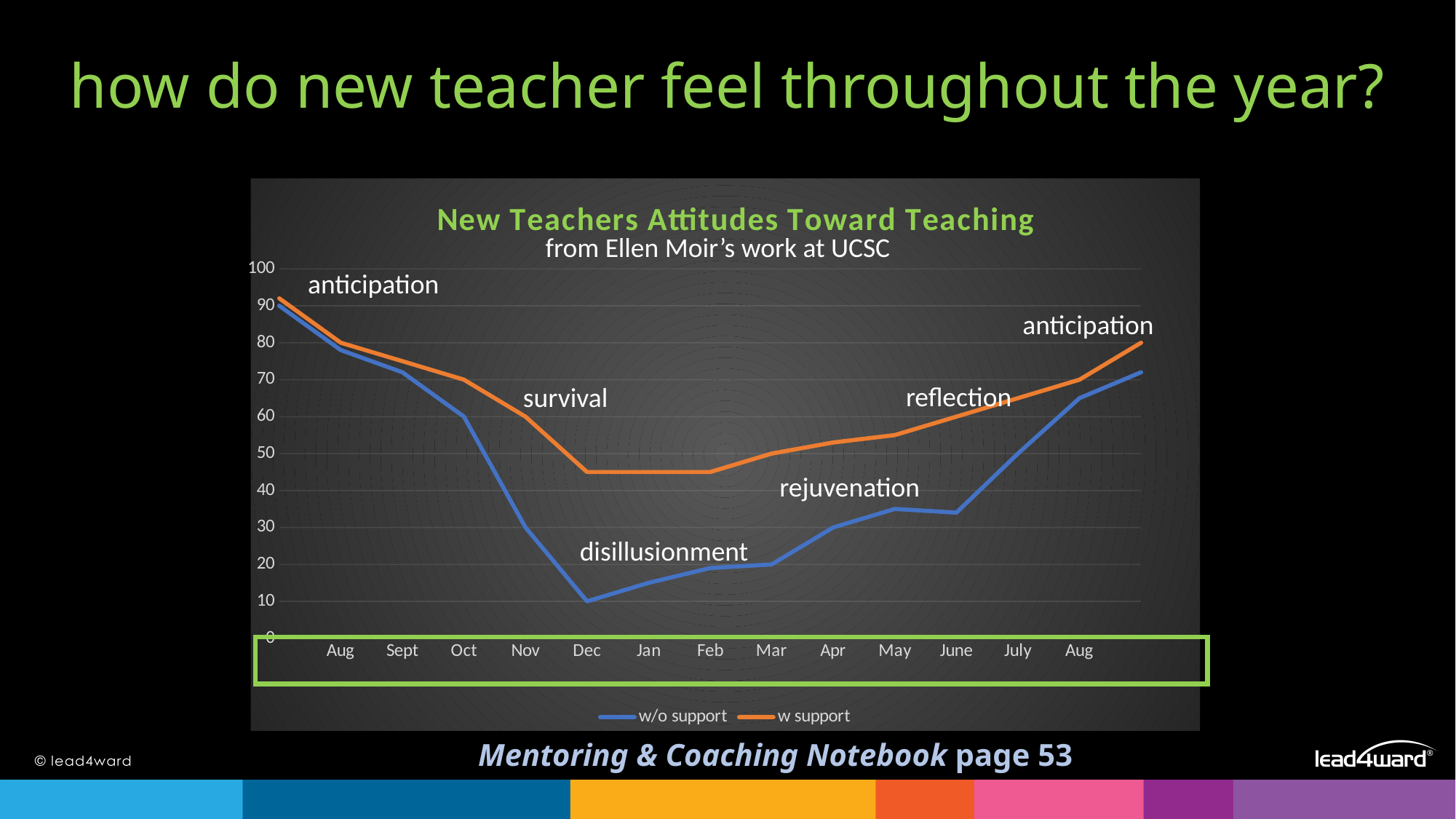
In which month does the w/o support line reach its lowest point? Dec What kind of chart is shown on the slide? line chart Is the value for w support in May greater or less than 50? greater How many series does the chart legend list? 2 How many months are labelled along the x axis? 13 In Dec, which series has the larger value, w/o support or w support? w support Is the value for w support in Dec greater or less than 40? greater Is the value for w/o support in Dec greater or less than 20? less What are the two series named in the legend? w/o support and w support What is the title of the chart? New Teachers Attitudes Toward Teaching Do the values for w/o support rise or fall from Aug to Dec? fall